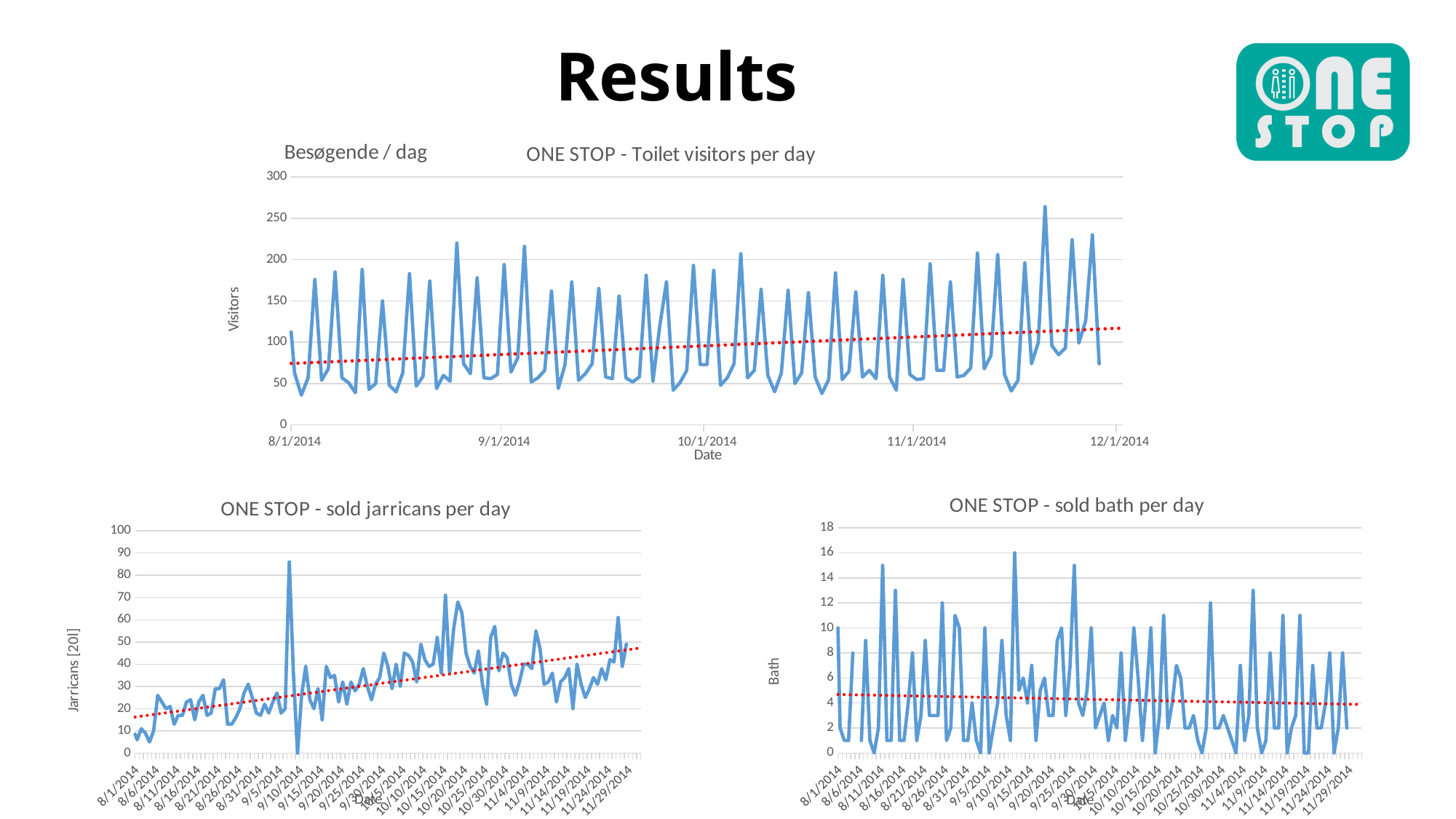
What is the y-axis label of the 'ONE STOP - Toilet visitors per day' chart? Visitors In the 'ONE STOP - Toilet visitors per day' chart, is the highest peak greater or less than 250? greater How many charts are shown on the slide? 3 What kind of chart is 'ONE STOP - Toilet visitors per day'? line chart In the 'ONE STOP - sold jarricans per day' chart, is the highest peak greater or less than 80? greater In the 'ONE STOP - sold bath per day' chart, is the highest peak greater or less than 14? greater In the 'ONE STOP - Toilet visitors per day' chart, does the dotted trend line rise or fall from August to December? rise What is the y-axis label of the 'ONE STOP - sold jarricans per day' chart? Jarricans [20l] In the 'ONE STOP - sold jarricans per day' chart, does the dotted trend line rise or fall along the x axis? rise In the 'ONE STOP - sold bath per day' chart, does the dotted trend line rise or fall along the x axis? fall